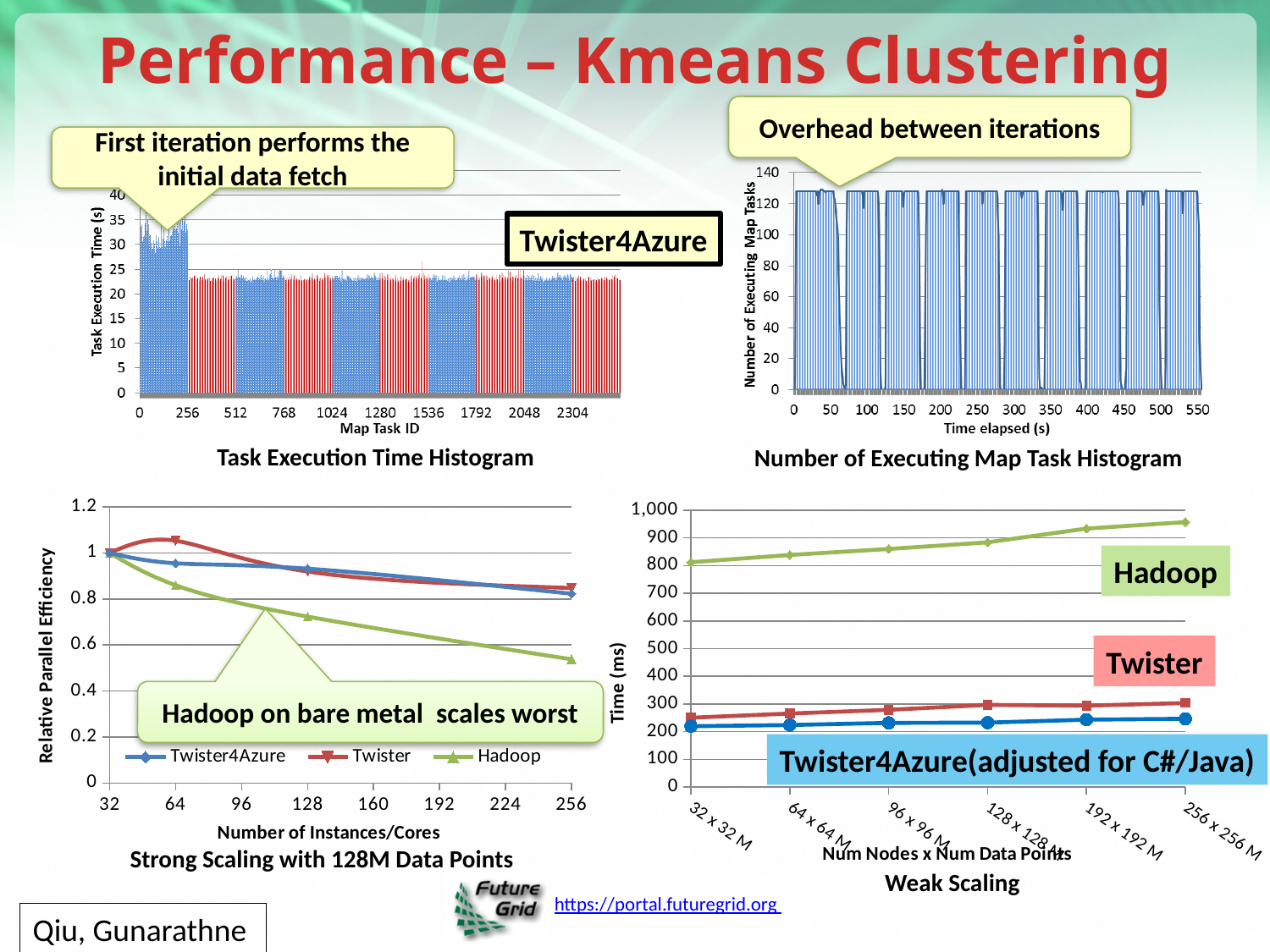
In the Strong Scaling with 128M Data Points chart, is the relative parallel efficiency of Hadoop at 256 instances/cores greater or less than 0.6? less In the Strong Scaling with 128M Data Points chart, does the relative parallel efficiency of Hadoop rise or fall as the number of instances/cores increases? fall In the Number of Executing Map Task Histogram, is the peak number of executing map tasks greater or less than 100? greater In the Weak Scaling chart, is the time for Hadoop at 256 x 256 M greater or less than 900 ms? greater How many data points are plotted along the x axis of the Weak Scaling chart? 6 What is the x-axis label of the Number of Executing Map Task Histogram? Time elapsed (s) In the Strong Scaling with 128M Data Points chart, which series has the lowest relative parallel efficiency at 256 instances/cores? Hadoop In the Weak Scaling chart, which series has the highest time (ms) at 256 x 256 M? Hadoop What kind of chart is the Task Execution Time Histogram at the top left of the slide? bar chart How many series does the legend of the Strong Scaling with 128M Data Points chart list? 3